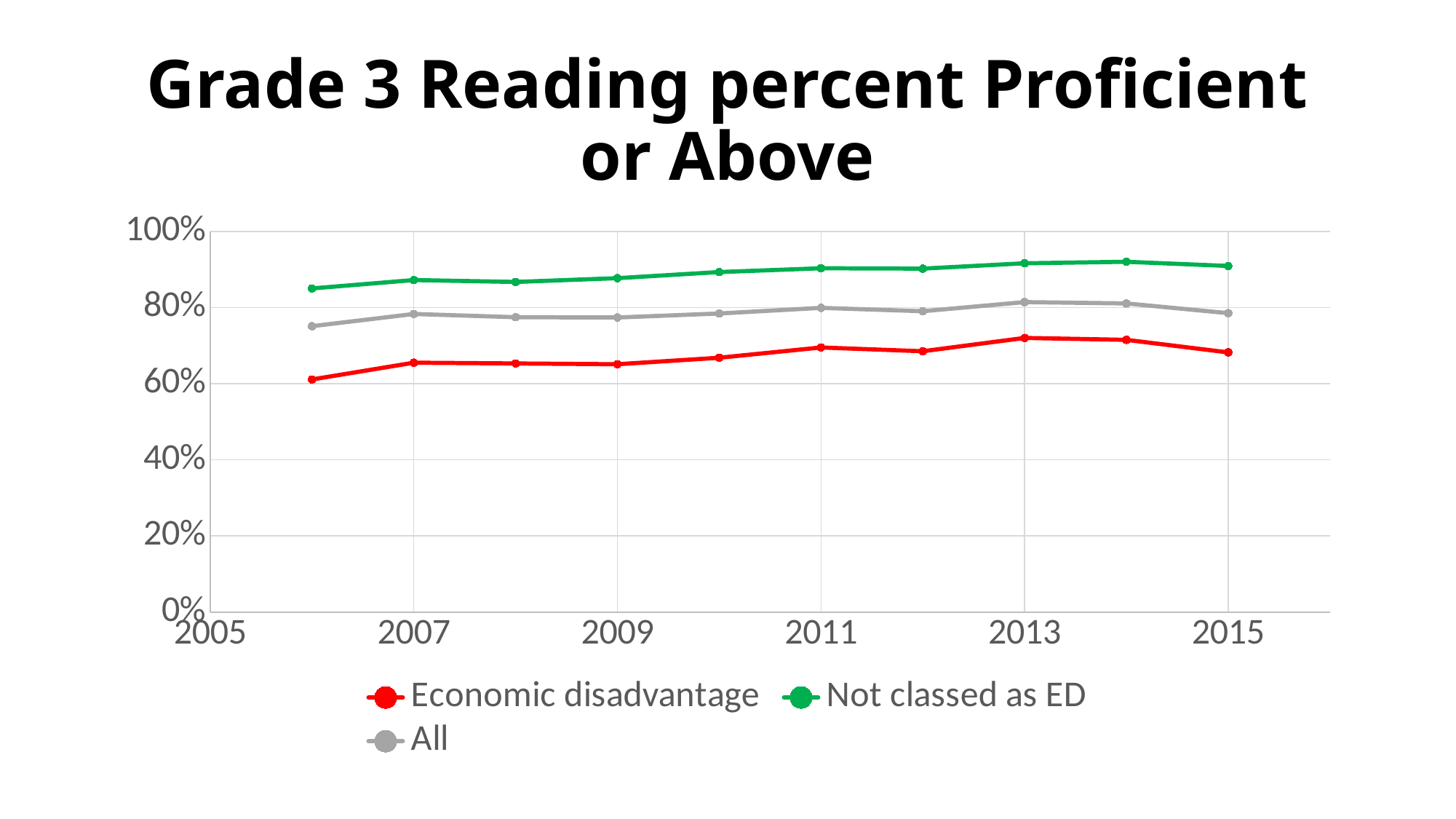
What kind of chart is shown on the slide? line chart Is the value for All in 2006 greater or less than 80%? less Is the value for Economic disadvantage in 2013 greater or less than 60%? greater In which year is the Economic disadvantage series at its lowest? 2006 Is the value for Not classed as ED in 2015 greater or less than 80%? greater How many series does the legend list? 3 Does the Economic disadvantage series rise or fall from 2006 to 2007? rise Which series has the highest values across all years? Not classed as ED In 2015, which is larger: the value for Not classed as ED or the value for Economic disadvantage? Not classed as ED Which series has the lowest values across all years? Economic disadvantage What colour is the line for the All series? grey How many data points are plotted for the Economic disadvantage series? 10